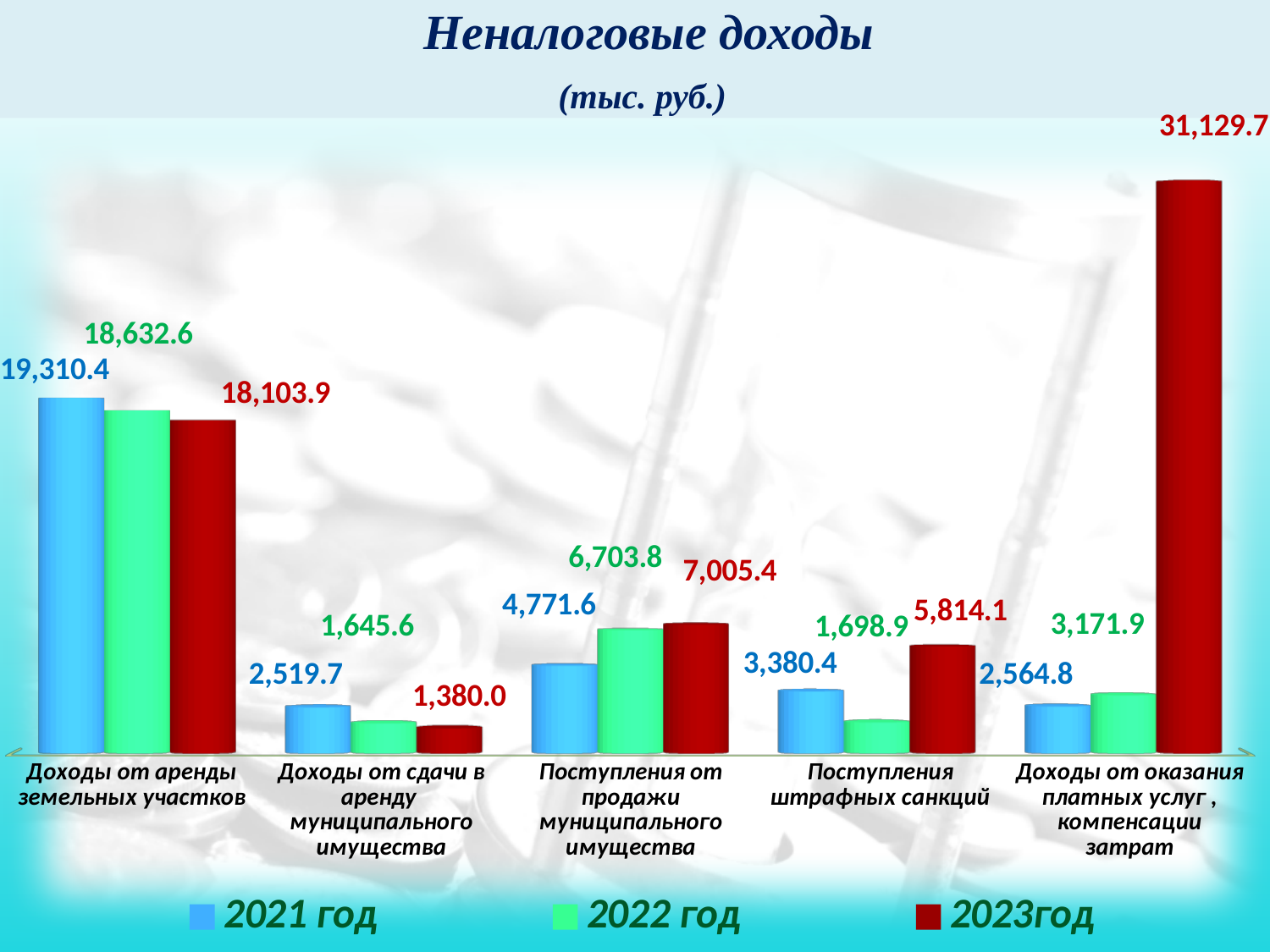
What is the value for 2023 год for Доходы от оказания платных услуг, компенсации затрат? 31,129.7 What type of chart is shown on the slide? bar chart What unit is given in the chart subtitle? тыс. руб. How many series does the legend list? 3 Do the values for Доходы от аренды земельных участков rise or fall from 2021 год to 2023 год? fall Which category has the lowest value for 2023 год? Доходы от сдачи в аренду муниципального имущества Which is larger for Поступления от продажи муниципального имущества: the 2021 год value or the 2022 год value? 2022 год What is the difference between the 2023 год and 2022 год values for Поступления штрафных санкций? 4,115.2 What is the value for 2021 год for Доходы от аренды земельных участков? 19,310.4 How many categories are shown on the x axis? 5 Which category has the highest value for 2021 год? Доходы от аренды земельных участков What is the value for 2022 год for Поступления штрафных санкций? 1,698.9